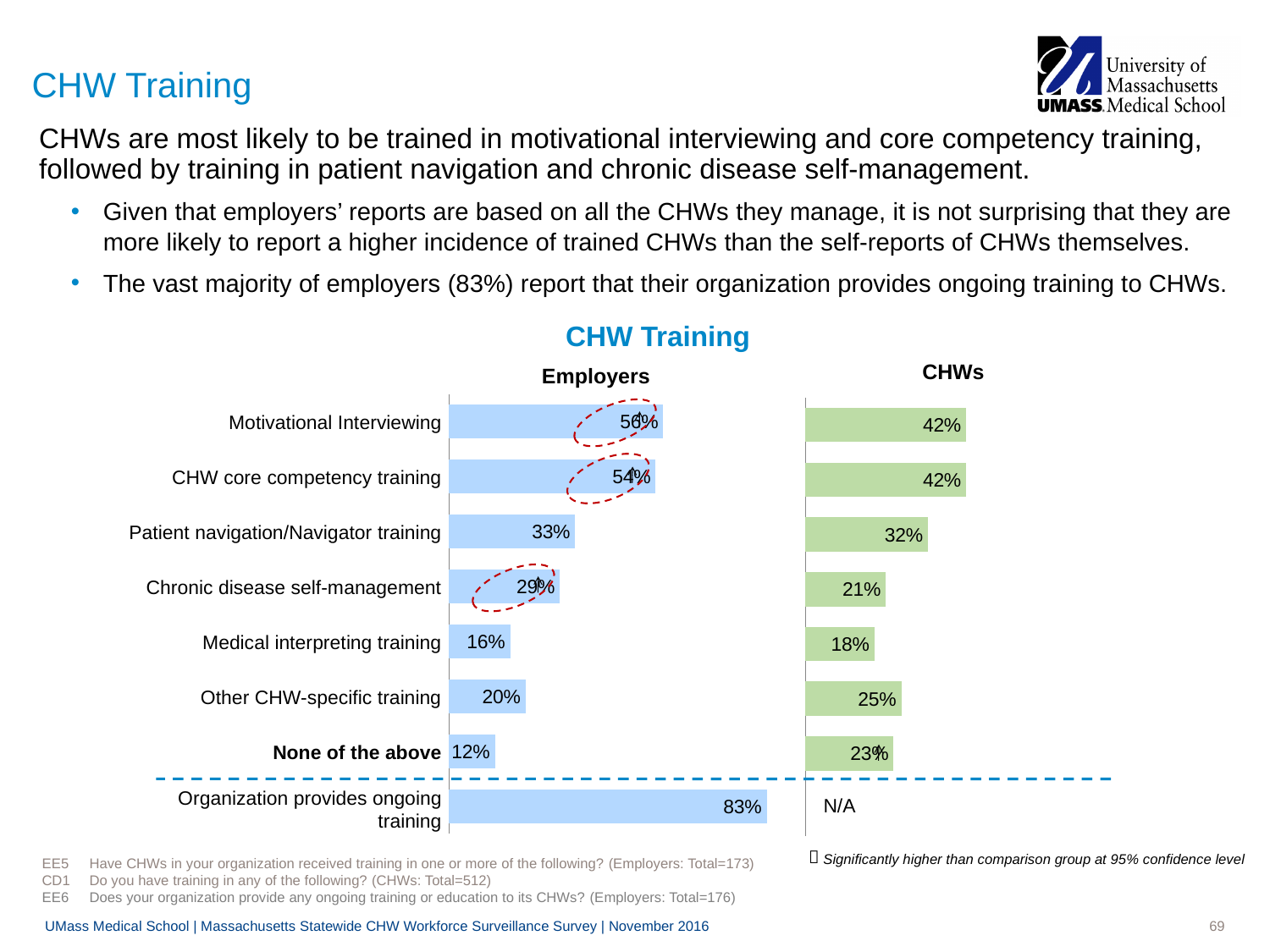
In the CHW Training chart, what percentage of employers report that their organization provides ongoing training? 83% What type of chart is the CHW Training chart? Bar chart How many training categories (including 'None of the above' and 'Organization provides ongoing training') are listed in the CHW Training chart? 8 In the CHW Training chart, which training category has the lowest value among CHWs? Medical interpreting training In the CHW Training chart, for Medical interpreting training, which group reports a higher value, employers or CHWs? CHWs In the CHW Training chart, which training category has the lowest value among employers? None of the above In the CHW Training chart, what is the difference between the employer and CHW values for 'None of the above'? 11 percentage points In the CHW Training chart, what percentage of CHWs report training in Patient navigation/Navigator training? 32% In the CHW Training chart, for Chronic disease self-management, which group reports a higher value, employers or CHWs? Employers In the CHW Training chart, what percentage of employers report CHWs trained in Motivational Interviewing? 56% In the CHW Training chart, what value is shown for CHWs for 'Organization provides ongoing training'? N/A In the CHW Training chart, what is the difference between the employer and CHW values for Motivational Interviewing? 14 percentage points